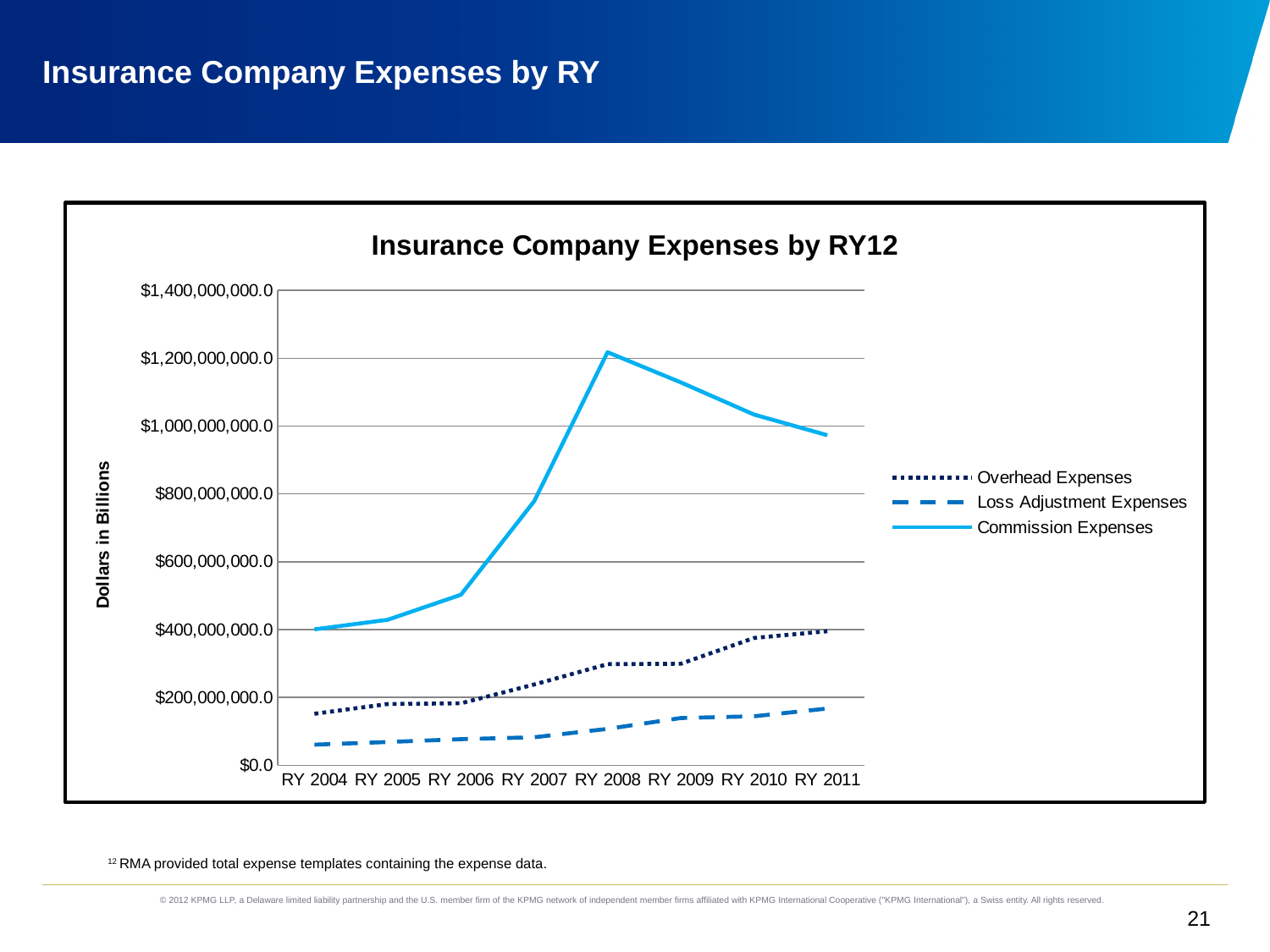
How many report years are plotted along the x axis? 8 Is the value for Loss Adjustment Expenses in RY 2011 greater or less than $200,000,000.0? less How many series does the legend list? 3 What kind of chart is shown on the slide? line chart In which report year do Commission Expenses reach their highest value? RY 2008 Do Commission Expenses rise or fall from RY 2008 to RY 2011? fall Which is larger in RY 2009: Overhead Expenses or Loss Adjustment Expenses? Overhead Expenses Is the value for Commission Expenses in RY 2008 greater or less than $1,000,000,000.0? greater Which series has the lowest values across all report years? Loss Adjustment Expenses Is the value for Commission Expenses in RY 2006 greater or less than $400,000,000.0? greater What is the label on the vertical axis of the chart? Dollars in Billions